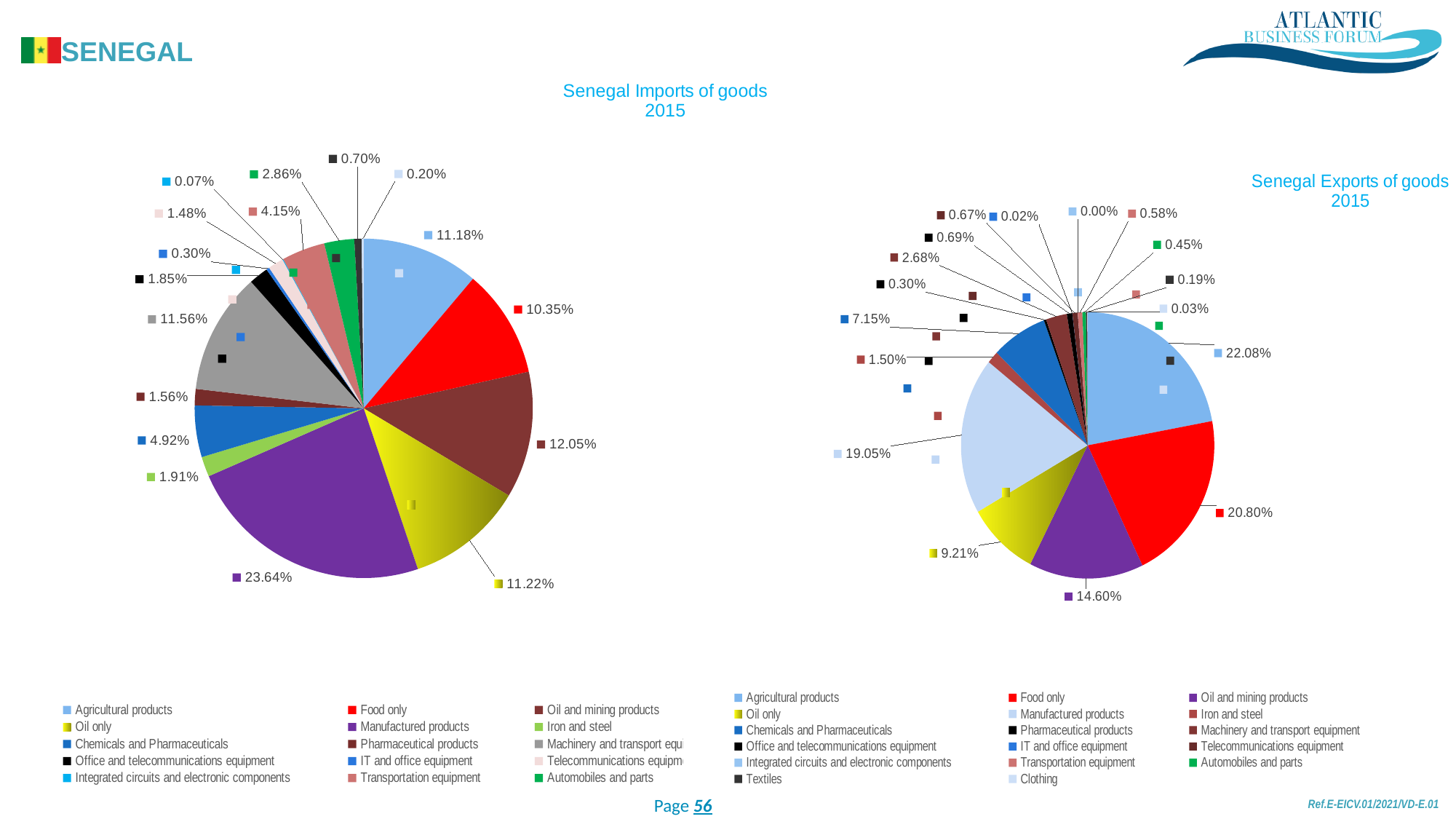
In the Senegal Exports of goods 2015 chart, what share is shown for Oil only? 9.21% In the Senegal Imports of goods 2015 chart, what is the difference between the Manufactured products share and the Oil and mining products share? 11.59% In the Senegal Imports of goods 2015 chart, what share is shown for Manufactured products? 23.64% How many categories does the legend of the Senegal Exports of goods 2015 chart list? 17 In the Senegal Imports of goods 2015 chart, what share is shown for Machinery and transport equipment? 11.56% In the Senegal Imports of goods 2015 chart, which is larger: Oil and mining products or Oil only? Oil and mining products In the Senegal Imports of goods 2015 chart, what share is shown for Food only? 10.35% In the Senegal Exports of goods 2015 chart, which category has the largest slice? Agricultural products What kind of chart is used for Senegal Imports of goods 2015? Pie chart In the Senegal Exports of goods 2015 chart, what is the difference between the Agricultural products share and the Food only share? 1.28% In the Senegal Imports of goods 2015 chart, which category has the largest slice? Manufactured products In the Senegal Exports of goods 2015 chart, what share is shown for Agricultural products? 22.08%